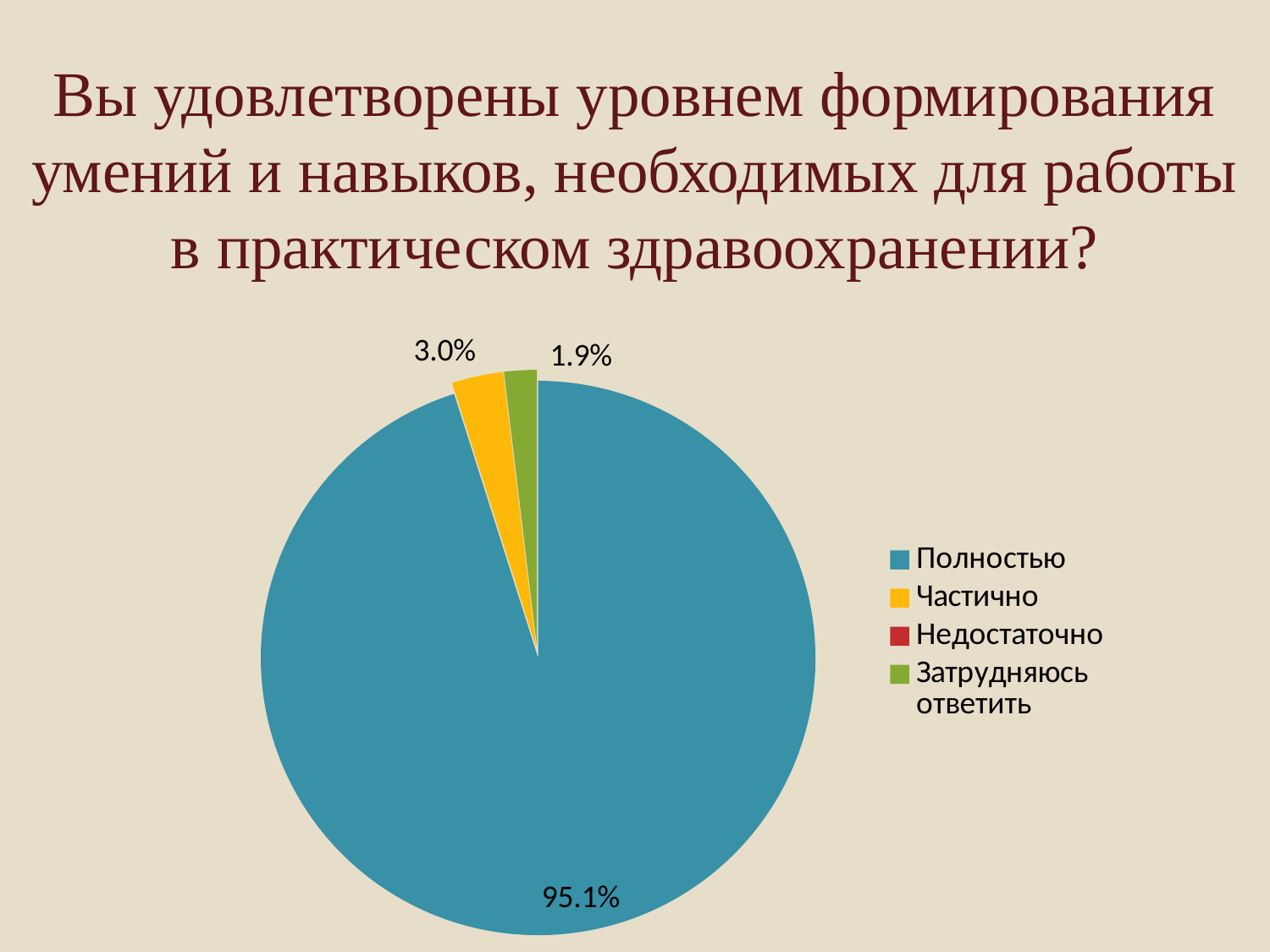
Which is larger, the share for "Частично" or the share for "Затрудняюсь ответить"? Частично How many slices have a percentage label printed on the chart? 3 How many answer options does the legend list? 4 What share of respondents answered "Частично"? 3.0% What is the difference between the shares for "Частично" and "Затрудняюсь ответить"? 1.1% What is the difference between the shares for "Полностью" and "Частично"? 92.1% What share of respondents answered "Полностью"? 95.1% Which answer option has the largest share of the pie? Полностью What share of respondents answered "Затрудняюсь ответить"? 1.9% Which legend entry is shown in red? Недостаточно What colour is the slice for "Полностью"? Blue What kind of chart is shown on the slide? Pie chart